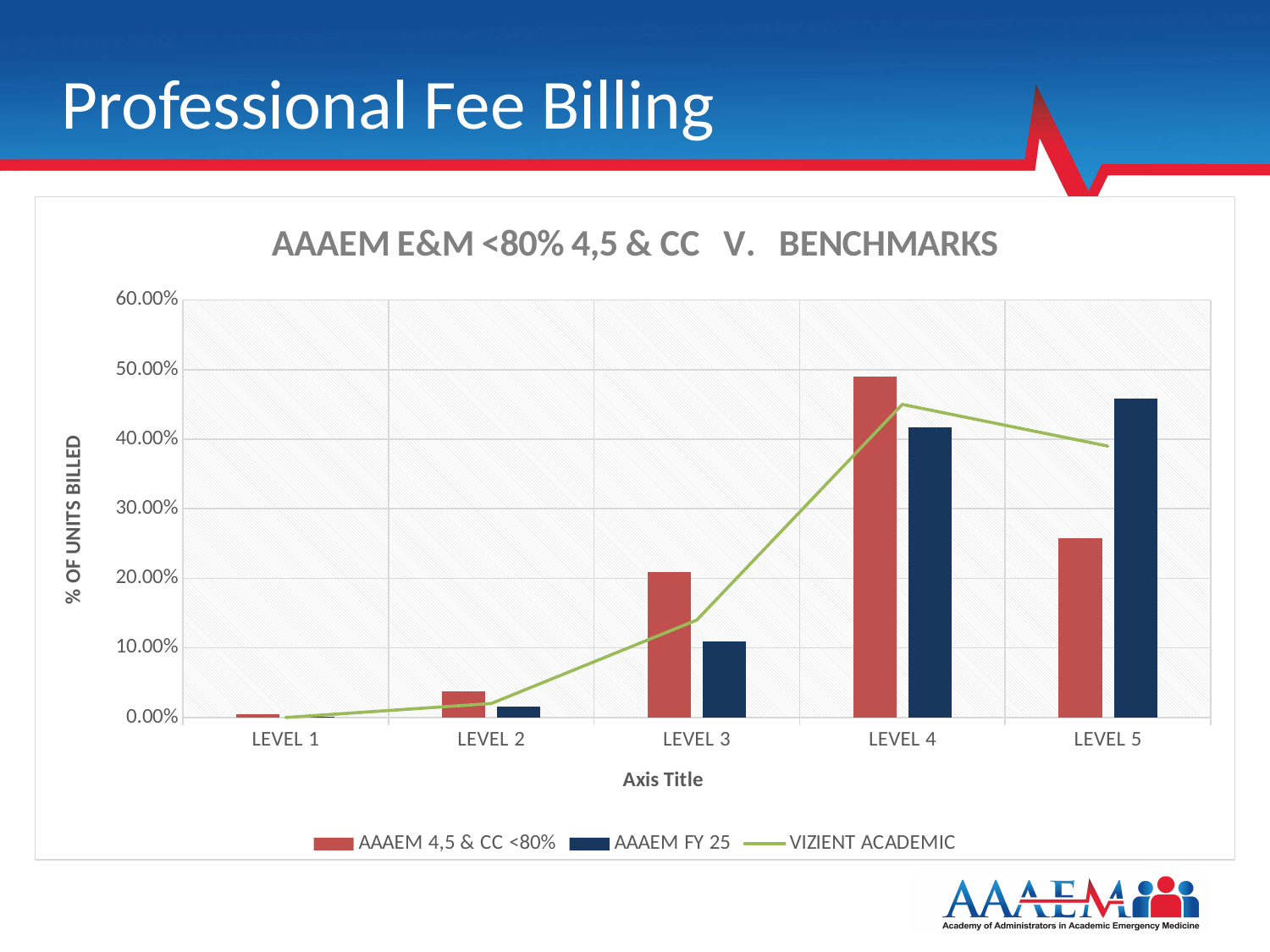
For the AAAEM FY 25 series, which level has the highest value? LEVEL 5 How many series does the legend list? 3 Is the VIZIENT ACADEMIC value for LEVEL 5 greater or less than 30.00%? greater What kind of chart is shown on the slide? bar and line chart Which series is drawn as a line rather than bars? VIZIENT ACADEMIC At LEVEL 5, which series has the larger value, AAAEM 4,5 & CC <80% or AAAEM FY 25? AAAEM FY 25 For the AAAEM 4,5 & CC <80% series, which level has the lowest value? LEVEL 1 Is the AAAEM FY 25 value for LEVEL 3 greater or less than 20.00%? less Is the AAAEM 4,5 & CC <80% value for LEVEL 4 greater or less than 40.00%? greater At LEVEL 4, which series has the larger value, AAAEM 4,5 & CC <80% or AAAEM FY 25? AAAEM 4,5 & CC <80% For the AAAEM 4,5 & CC <80% series, which level has the highest value? LEVEL 4 How many levels are shown on the x axis? 5